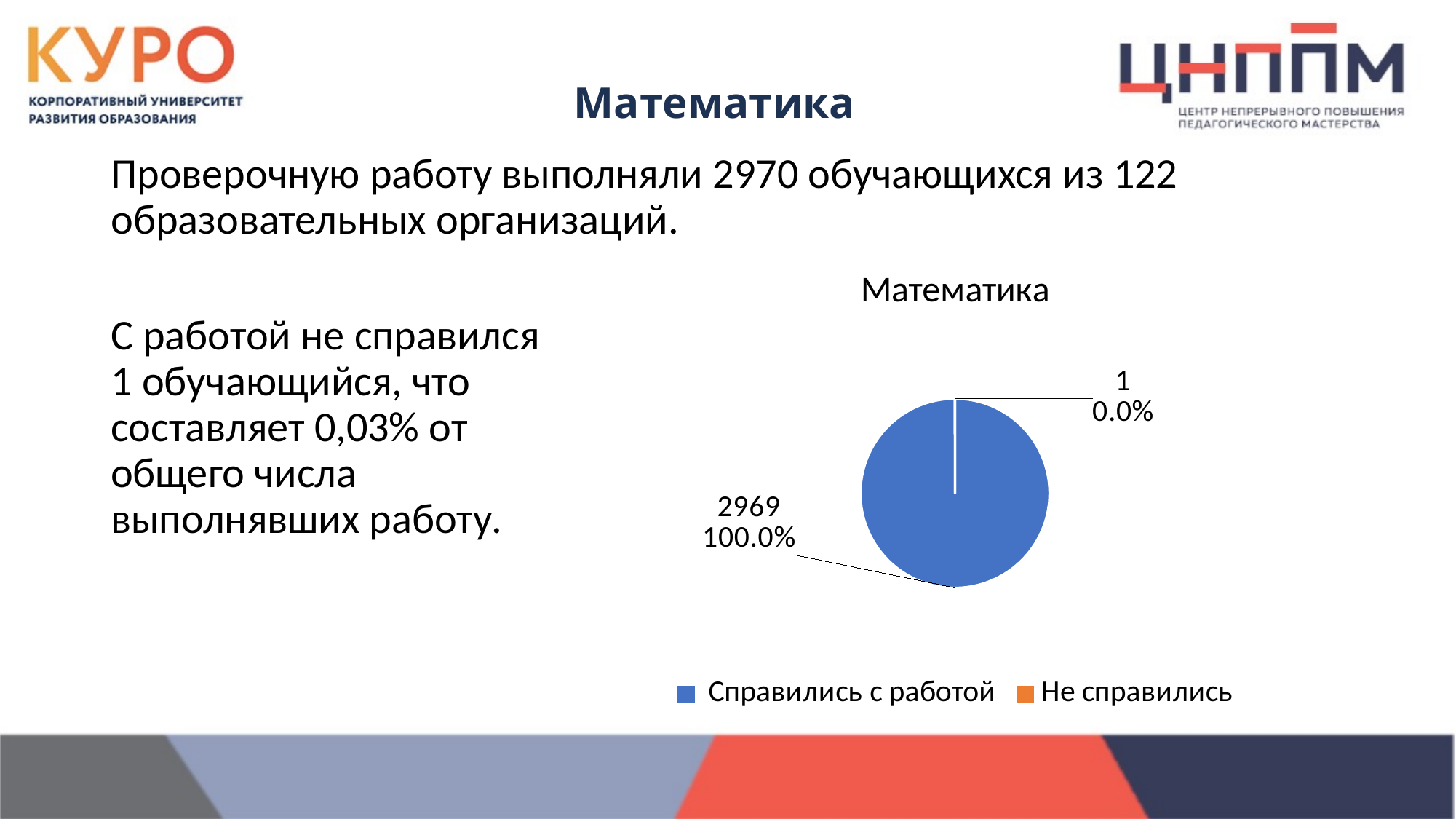
Which category has the smallest slice in the pie chart? Не справились What kind of chart is shown on the slide? pie chart What is the value for "Справились с работой" in the pie chart? 2969 What is the value for "Не справились" in the pie chart? 1 How many slices does the pie chart have? 2 How many entries does the chart legend list? 2 Which category has the largest slice in the pie chart? Справились с работой What colour is the slice for "Справились с работой"? blue What percentage share is shown for "Справились с работой"? 100.0% What percentage share is shown for "Не справились"? 0.0% What is the difference between the values for "Справились с работой" and "Не справились"? 2968 What is the title of the chart? Математика